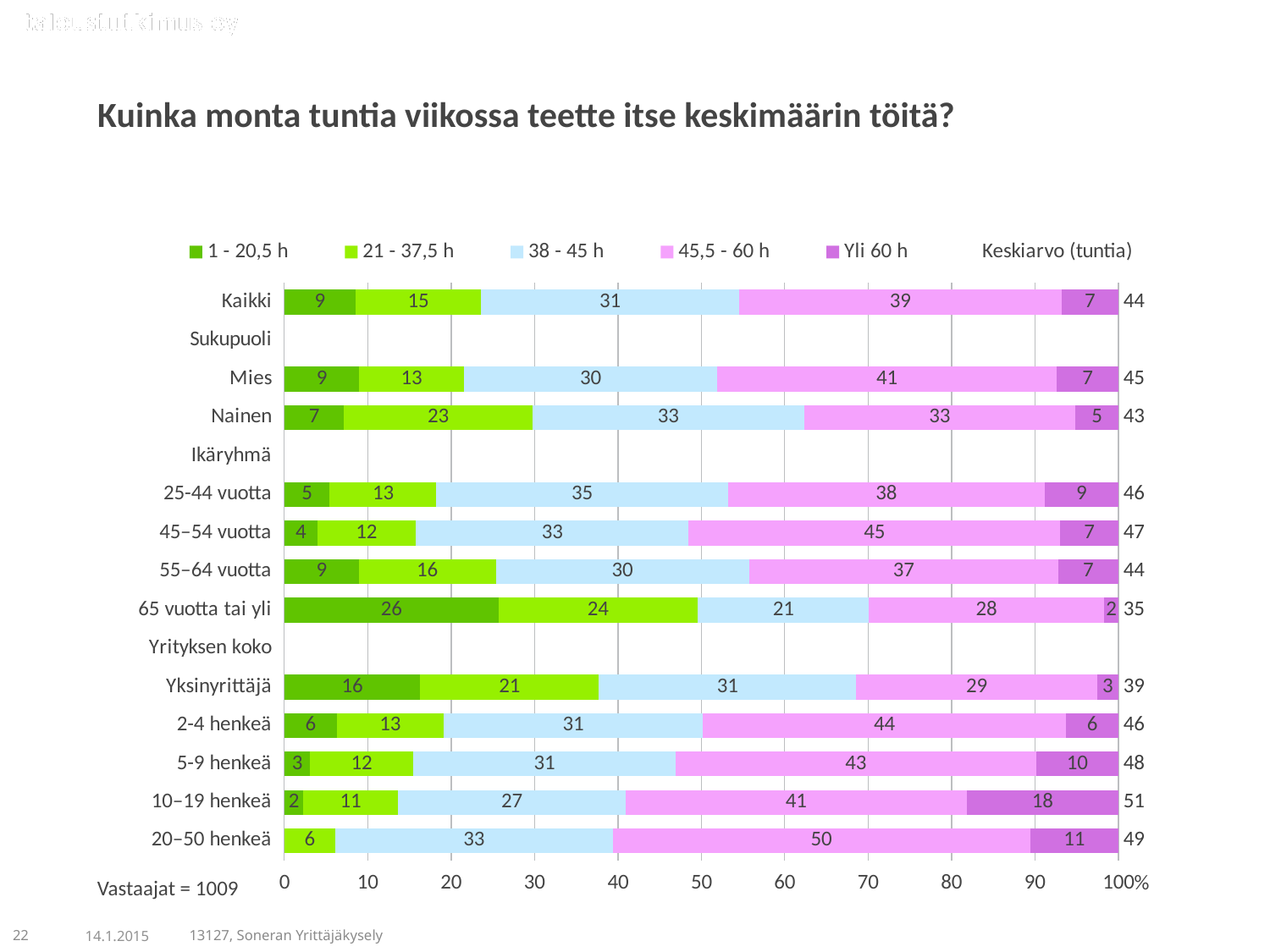
What kind of chart is shown on the slide? Stacked bar chart What is the value for 65 vuotta tai yli in the 1 - 20,5 h series? 26 Which category has the lowest Keskiarvo (tuntia)? 65 vuotta tai yli What is the value for 20–50 henkeä in the 45,5 - 60 h series? 50 Which category has the highest value in the Yli 60 h series? 10–19 henkeä What is the difference between Mies and Nainen in the 45,5 - 60 h series? 8 What is the title of the chart? Kuinka monta tuntia viikossa teette itse keskimäärin töitä? Which is larger in the 38 - 45 h series: 25-44 vuotta or 55–64 vuotta? 25-44 vuotta What is the value for Kaikki in the 45,5 - 60 h series? 39 What is the Keskiarvo (tuntia) shown for 10–19 henkeä? 51 Which category has the highest Keskiarvo (tuntia)? 10–19 henkeä What is the value for Nainen in the 21 - 37,5 h series? 23